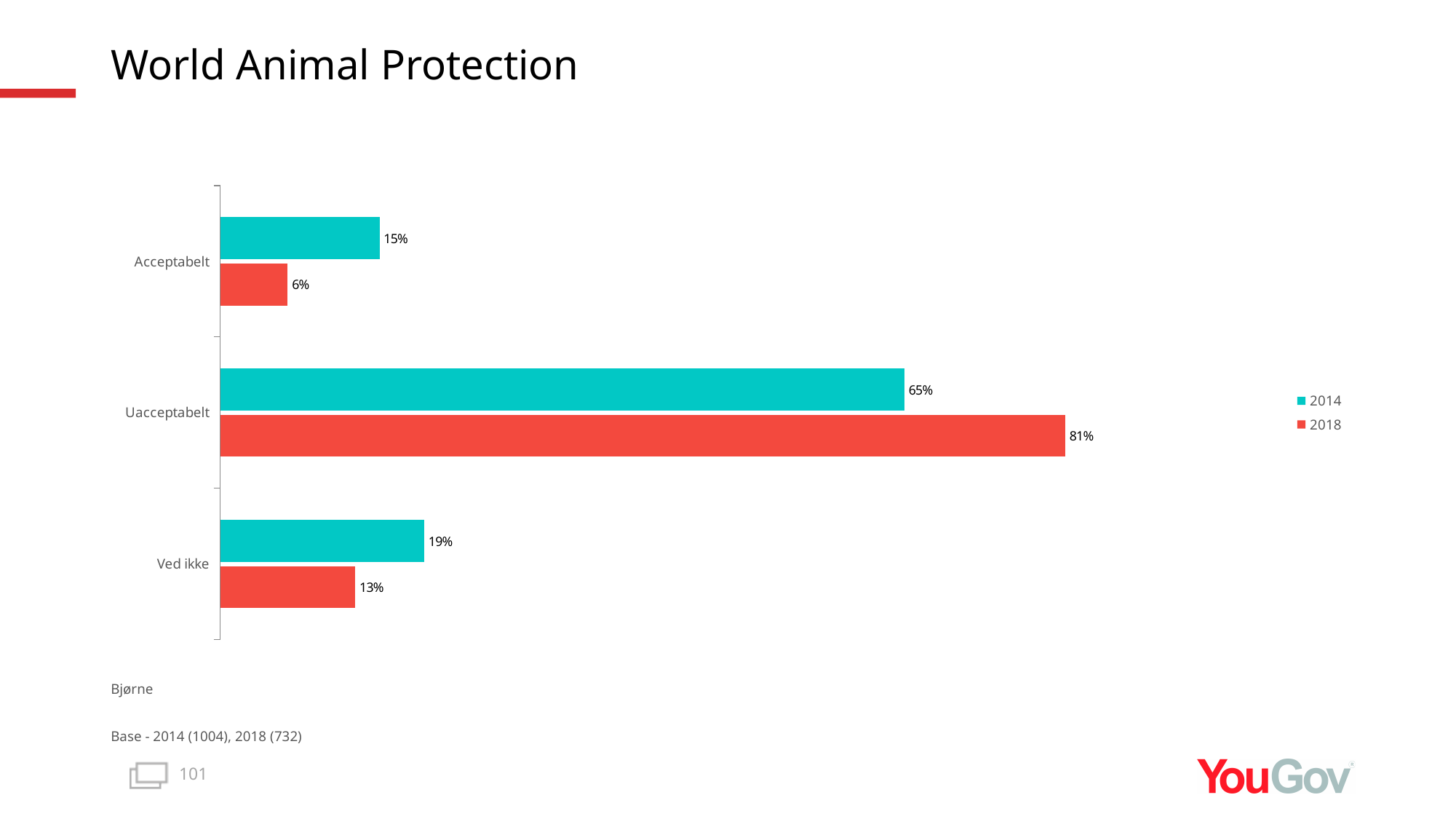
What is the difference between the 2014 and 2018 values for Acceptabelt? 9% Which category has the lowest 2018 value? Acceptabelt What kind of chart is shown on the slide? Bar chart What is the 2018 value for Uacceptabelt? 81% What is the 2014 value for Acceptabelt? 15% How many categories are shown on the chart? 3 What is the difference between the 2018 and 2014 values for Uacceptabelt? 16% What is the 2014 value for Ved ikke? 19% How many series does the legend list? 2 Which is larger for Ved ikke, the 2014 value or the 2018 value? 2014 What is the 2018 value for Ved ikke? 13% Which category has the highest 2018 value? Uacceptabelt